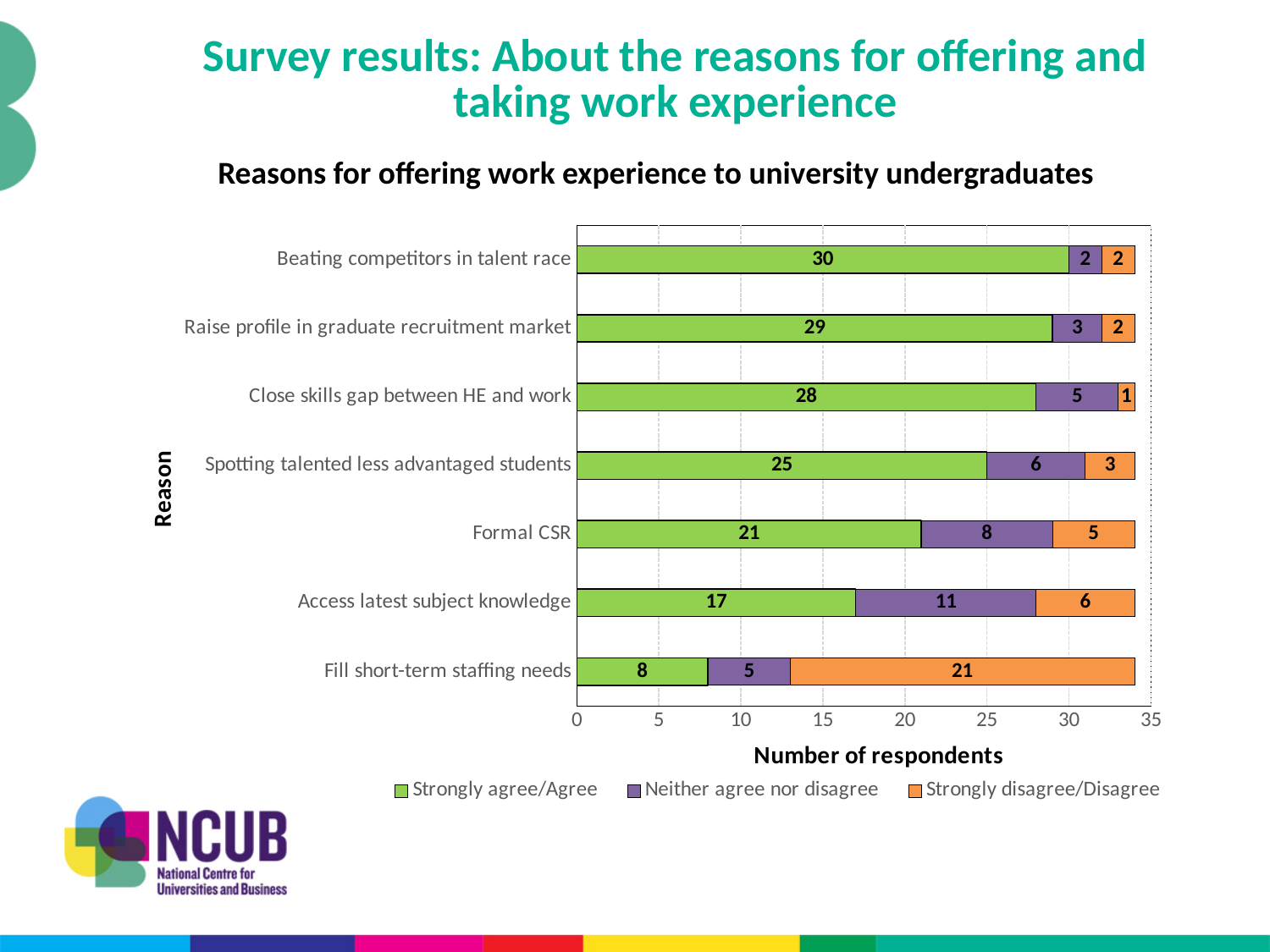
What is the total number of respondents for Close skills gap between HE and work? 34 How many reasons are shown on the chart? 7 What kind of chart is shown on the slide? Stacked bar chart What is the Strongly disagree/Disagree value for Fill short-term staffing needs? 21 What is the Strongly agree/Agree value for Beating competitors in talent race? 30 Which has a larger Neither agree nor disagree value: Formal CSR or Spotting talented less advantaged students? Formal CSR How many series does the legend list? 3 Which reason has the lowest Strongly agree/Agree value? Fill short-term staffing needs Which reason has the highest Strongly agree/Agree value? Beating competitors in talent race What is the difference between the Strongly agree/Agree values for Formal CSR and Access latest subject knowledge? 4 What is the Neither agree nor disagree value for Access latest subject knowledge? 11 What is the label of the x axis? Number of respondents